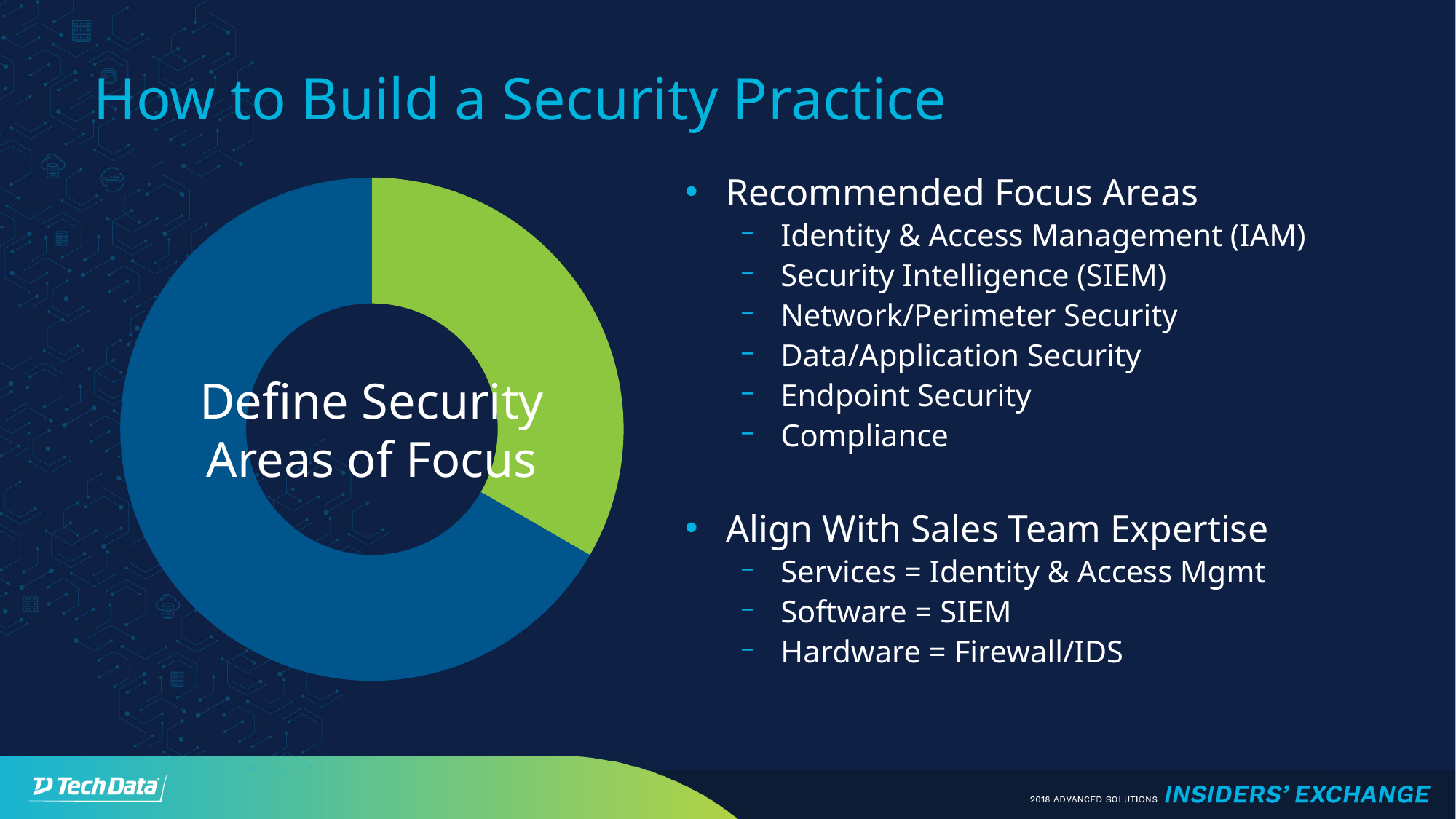
Which slice of the doughnut chart is the smallest? The green slice What kind of chart is shown on the slide? Doughnut chart Which slice of the doughnut chart is larger, the blue one or the green one? The blue one What text is written in the centre of the doughnut chart? Define Security Areas of Focus What two colours are used for the slices of the doughnut chart? Blue and green How many slices does the doughnut chart have? 2